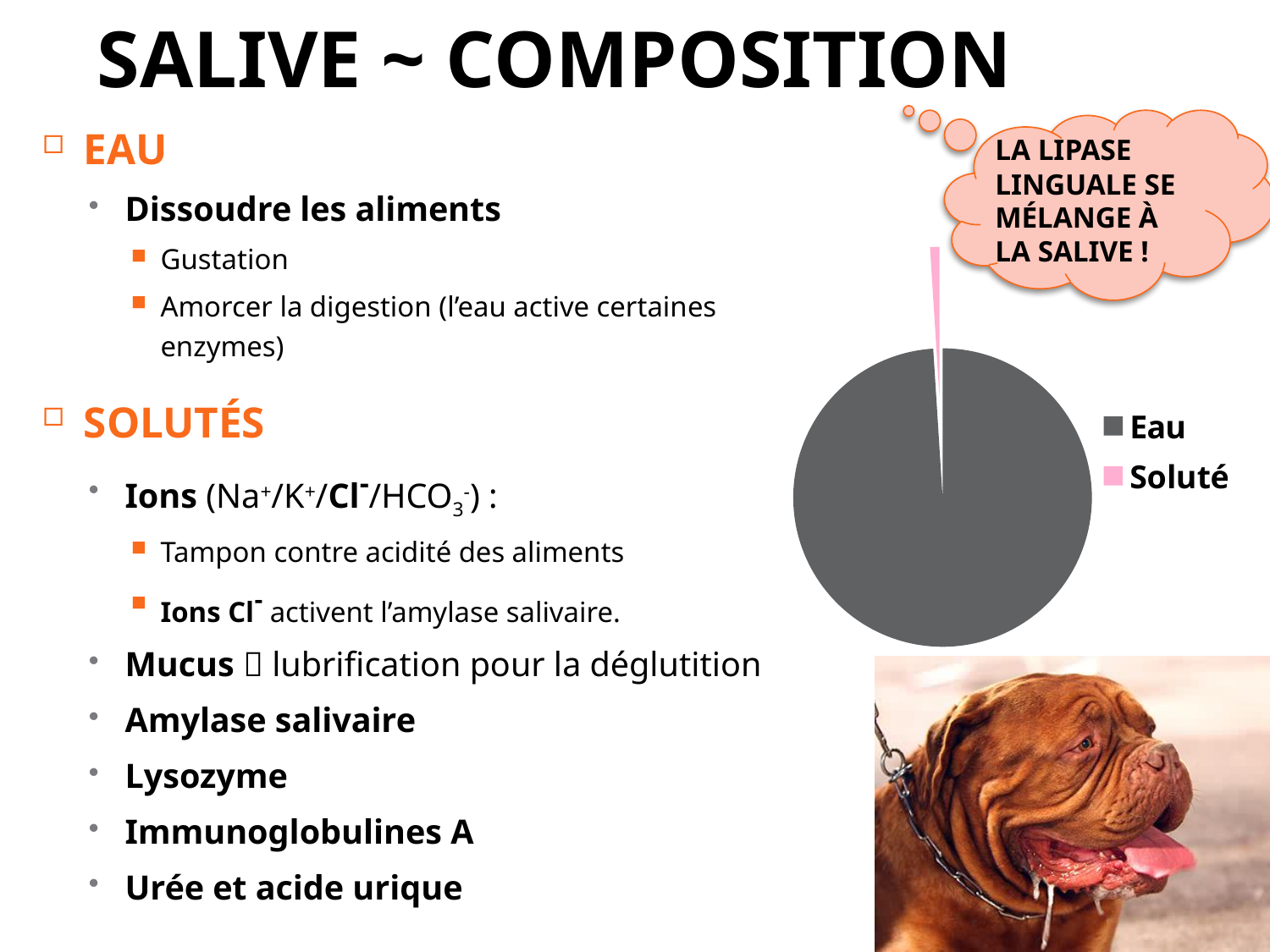
Which is larger in the pie chart, Eau or Soluté? Eau What kind of chart is shown on the slide? pie chart How many slices does the pie chart have? 2 What colour is the Eau slice in the pie chart? grey What colour is the Soluté slice in the pie chart? pink Which category takes up the largest share of the pie chart? Eau Which category takes up the smallest share of the pie chart? Soluté How many entries does the legend of the pie chart list? 2